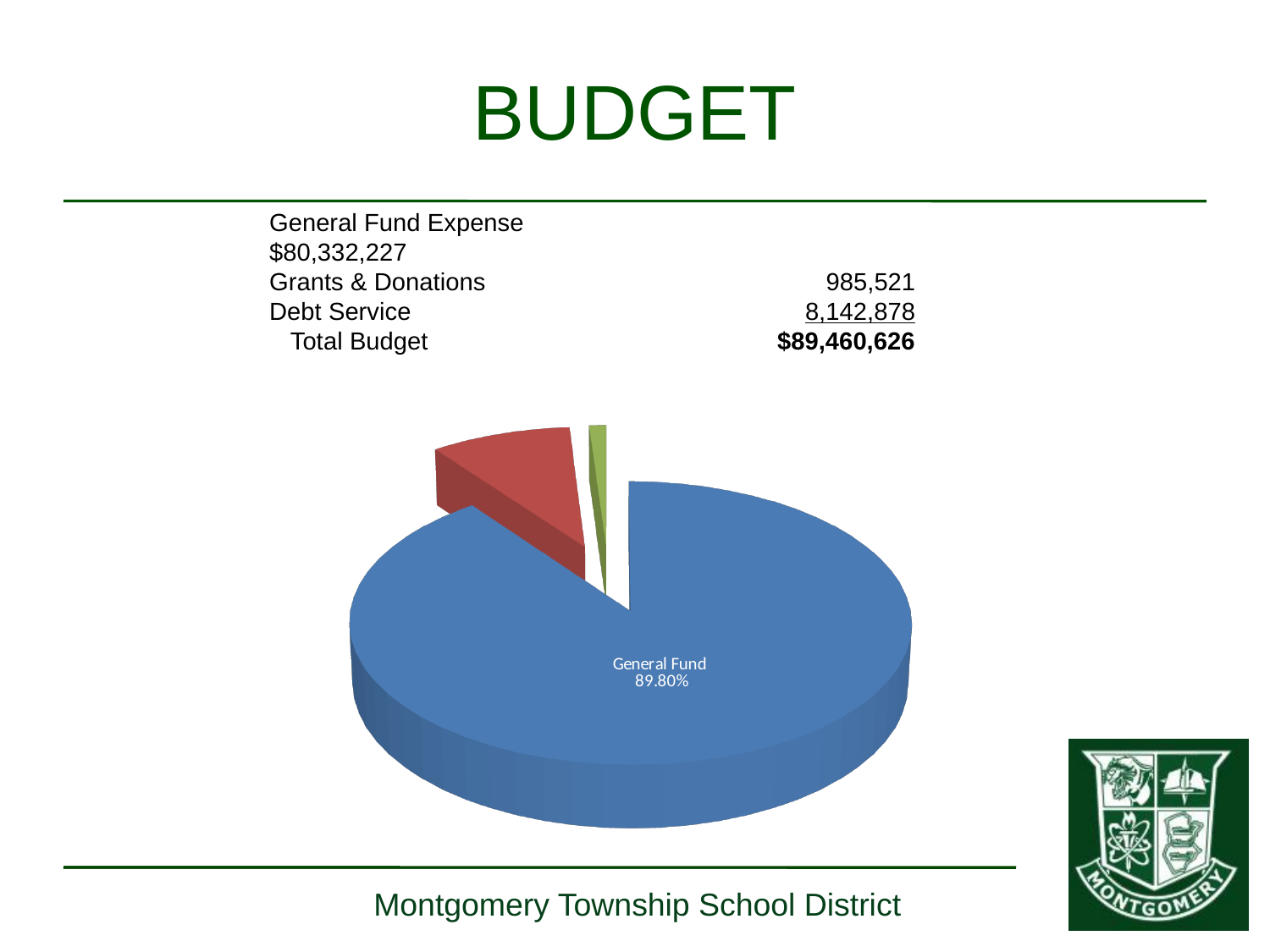
What share of the pie does the General Fund slice represent? 89.80% What kind of chart is shown on the slide? pie chart Which slice of the pie chart has a data label printed on it? General Fund Is the General Fund share of the pie greater or less than 50%? greater What colour is the General Fund slice in the pie chart? blue Which slice of the pie chart is the largest? General Fund How many slices does the pie chart have? 3